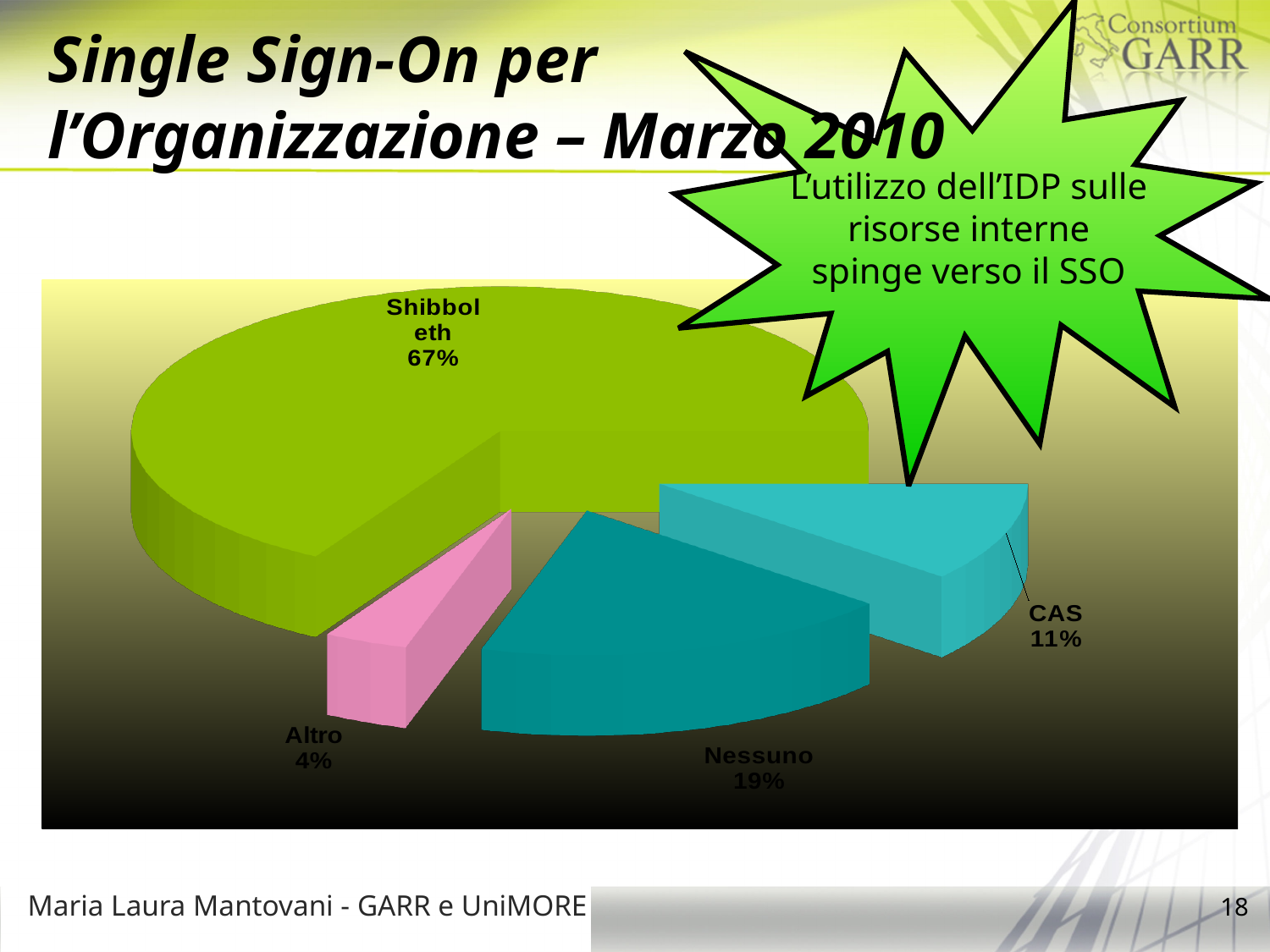
How many slices does the pie chart have? 4 What share of the pie does Nessuno have? 19% What share of the pie does Altro have? 4% Which slice of the pie is the largest? Shibboleth Which slice of the pie is the smallest? Altro What kind of chart is shown on the slide? pie chart Which is larger, the share for Nessuno or the share for CAS? Nessuno What is the difference in percentage points between Shibboleth and Nessuno? 48 What share of the pie does CAS have? 11% What is the difference in percentage points between CAS and Altro? 7 What colour is the Altro slice of the pie? pink What share of the pie does Shibboleth have? 67%